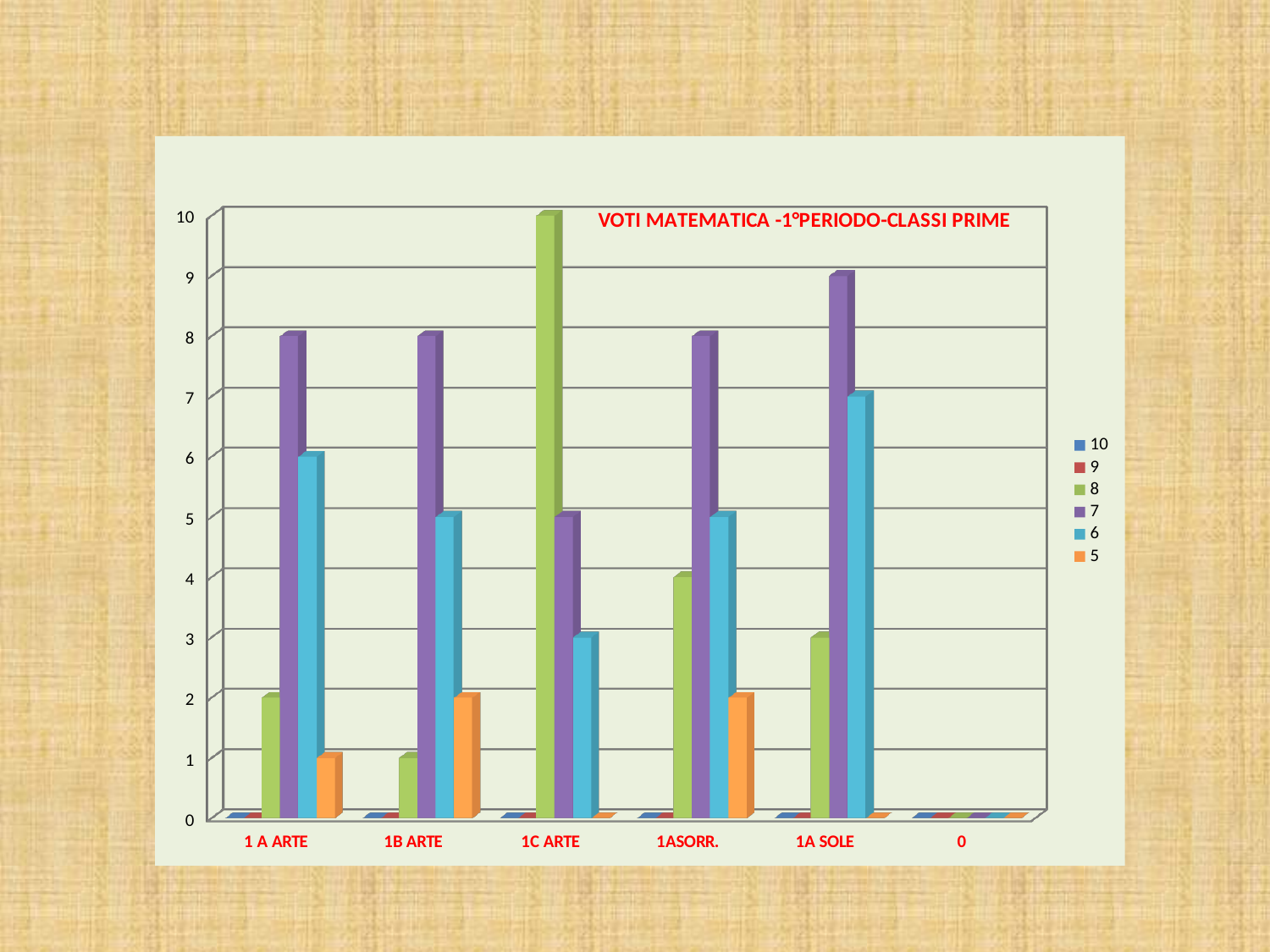
What is the value of series 7 for 1A SOLE? 9 Which category has the highest value for series 8? 1C ARTE How many series does the legend list? 6 What is the title of the chart? VOTI MATEMATICA -1°PERIODO-CLASSI PRIME Which is larger for 1ASORR.: series 7 or series 6? series 7 Is the value of series 6 for 1A SOLE greater or less than 5? greater What is the value of series 6 for 1 A ARTE? 6 How many categories are shown on the x axis? 6 Which category has the highest value for series 7? 1A SOLE What kind of chart is shown on the slide? bar chart What is the value of series 8 for 1C ARTE? 10 Which series is shown in green in the legend? 8